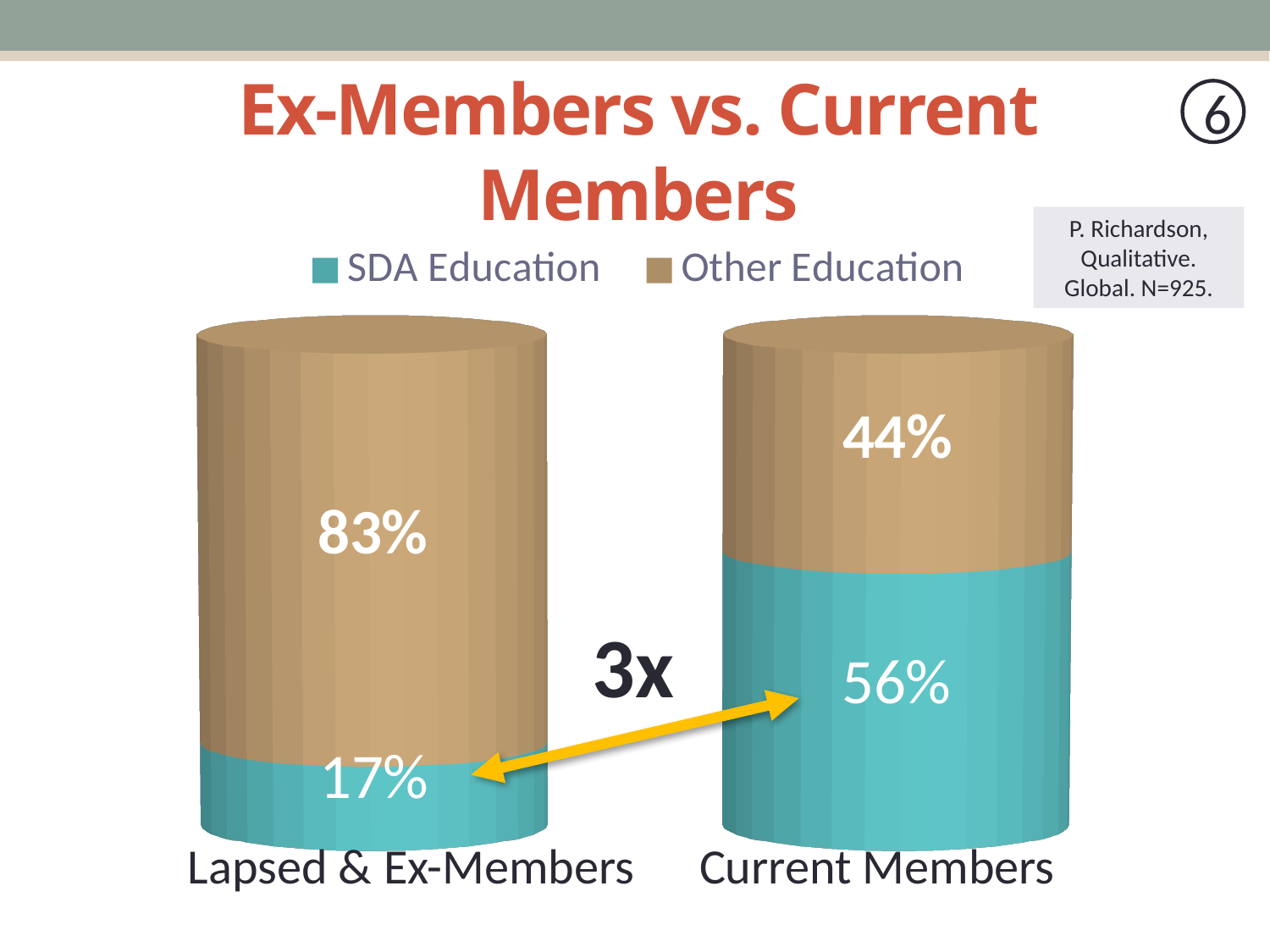
What kind of chart is shown on the slide? Stacked bar chart Which category has the higher SDA Education value? Current Members What is the title of the chart? Ex-Members vs. Current Members Is the Other Education value larger for Lapsed & Ex-Members or for Current Members? Lapsed & Ex-Members What is the Other Education value for Lapsed & Ex-Members? 83% What is the SDA Education value for Lapsed & Ex-Members? 17% How many categories are shown on the x axis? 2 What is the difference between the SDA Education values for Current Members and Lapsed & Ex-Members? 39% What is the SDA Education value for Current Members? 56% How many series does the legend list? 2 What is the Other Education value for Current Members? 44% Which category has the lower Other Education value? Current Members